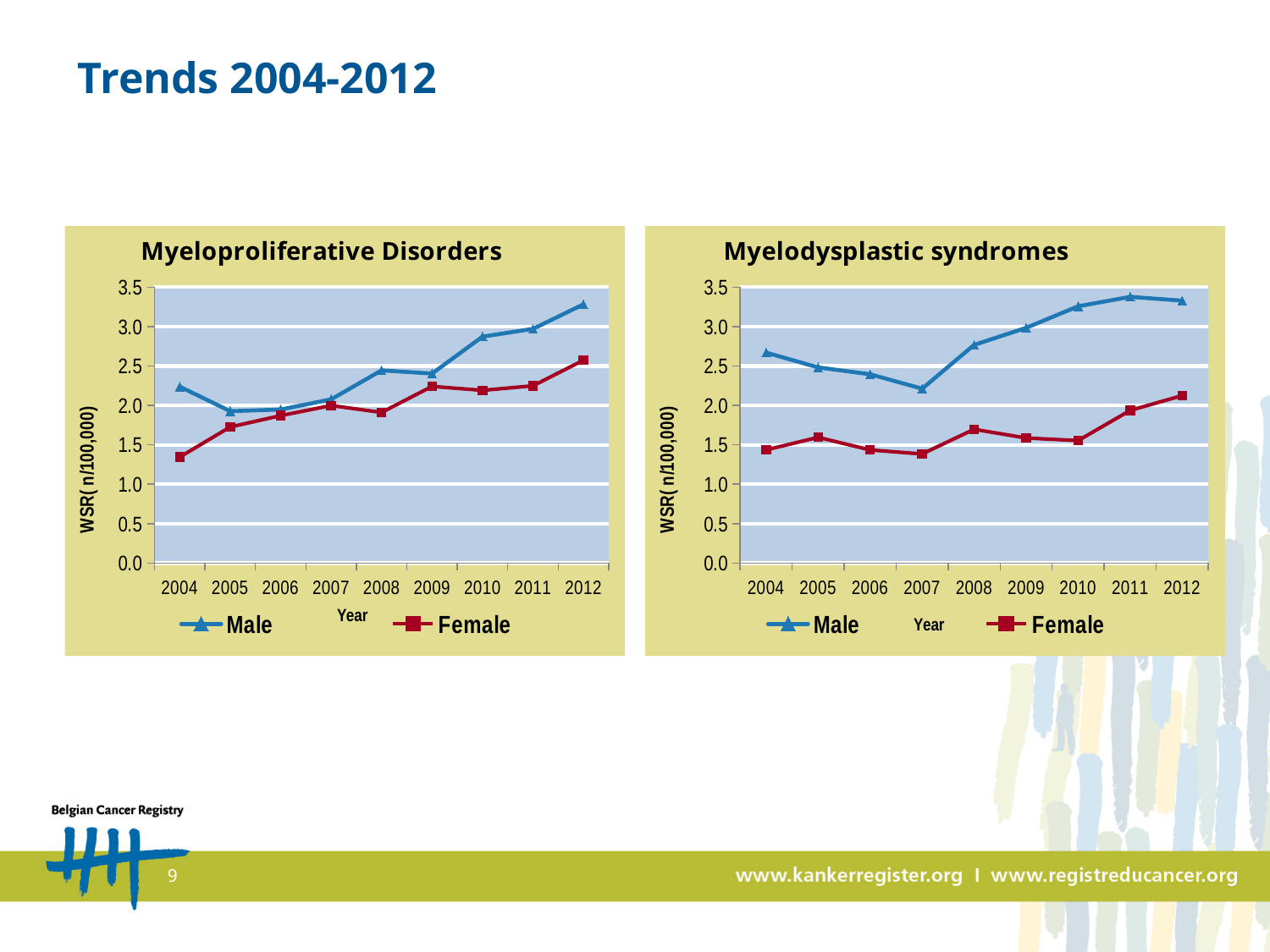
What is the y-axis label of the Myelodysplastic syndromes chart? WSR( n/100,000) How many years are plotted along the x axis of the Myeloproliferative Disorders chart? 9 How many series does the legend of the Myelodysplastic syndromes chart list? 2 What kind of chart is the Myeloproliferative Disorders chart? line chart In the Myeloproliferative Disorders chart, in which year is the Male value highest? 2012 In the Myelodysplastic syndromes chart, is the Male value for 2007 greater or less than 2.5? less In the Myeloproliferative Disorders chart, is the Female value for 2004 greater or less than 1.5? less In the Myelodysplastic syndromes chart, in which year is the Male value lowest? 2007 In the Myeloproliferative Disorders chart, in which year is the Female value lowest? 2004 In the Myelodysplastic syndromes chart, which series has the higher value in 2004, Male or Female? Male In the Myelodysplastic syndromes chart, is the Female value for 2012 greater or less than 2.0? greater